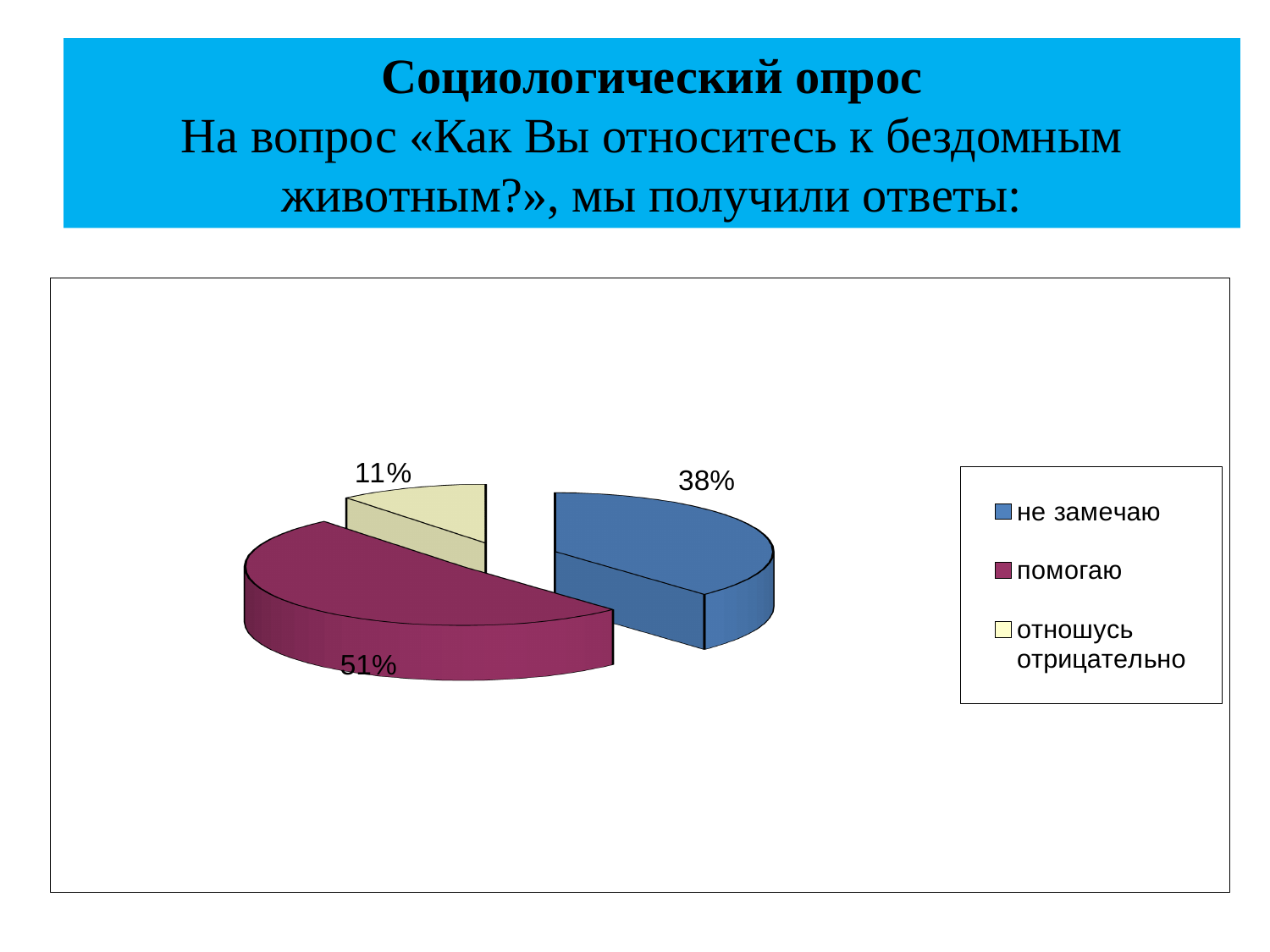
What is the difference in percentage points between "помогаю" and "не замечаю"? 13 Which is larger: the share for "не замечаю" or for "отношусь отрицательно"? не замечаю What is the difference in percentage points between "не замечаю" and "отношусь отрицательно"? 27 What colour is the slice for "помогаю"? purple What kind of chart is shown on the slide? pie chart What share of respondents answered "отношусь отрицательно"? 11% What share of respondents answered "не замечаю"? 38% How many slices does the pie chart have? 3 How many entries does the legend list? 3 What share of respondents answered "помогаю"? 51% Which answer has the smallest share of the pie? отношусь отрицательно Which answer has the largest share of the pie? помогаю